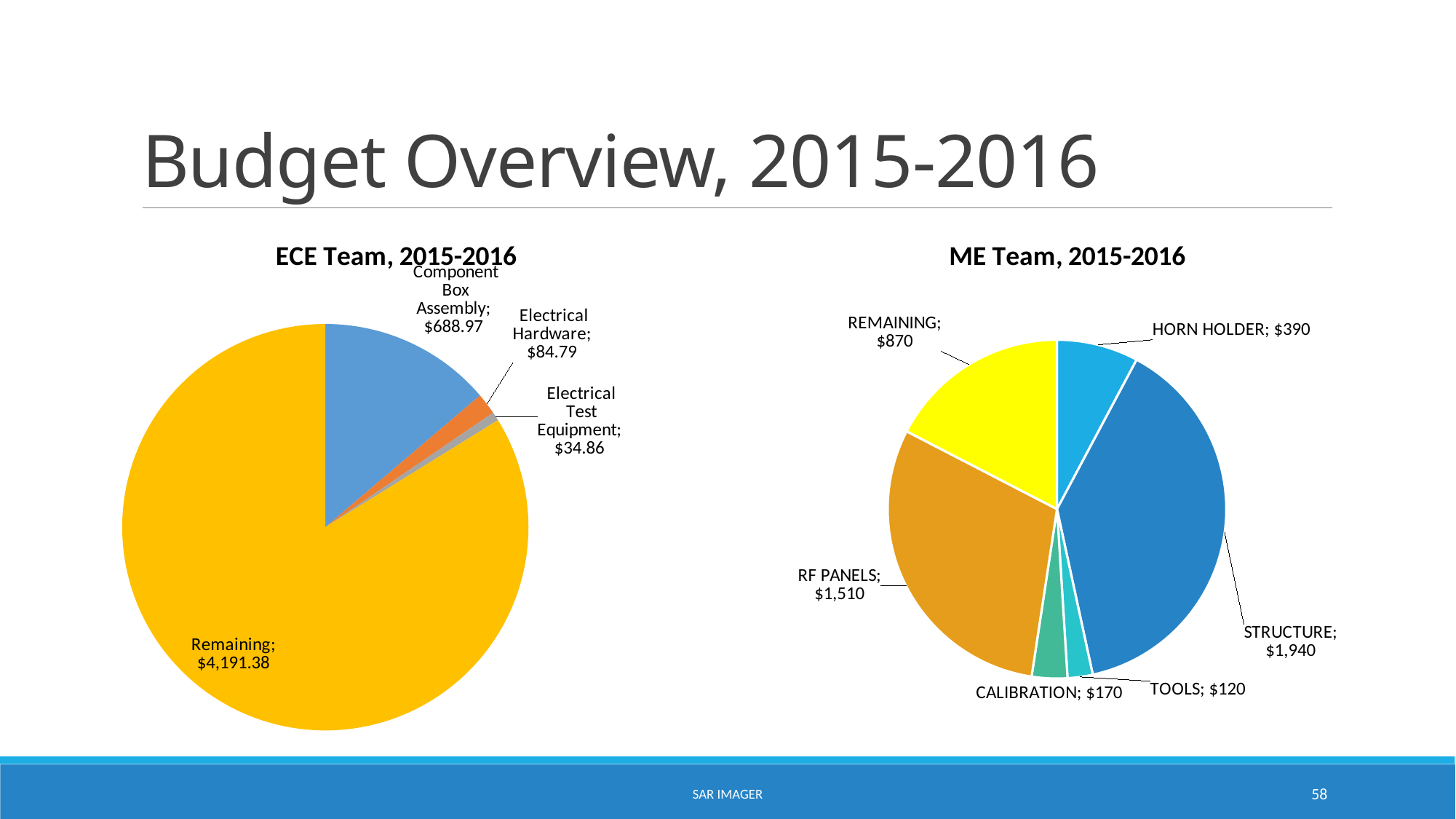
In the ECE Team, 2015-2016 chart, what is the difference between Component Box Assembly and Electrical Hardware? $604.18 In the ME Team, 2015-2016 chart, what is the value for RF PANELS? $1,510 In the ECE Team, 2015-2016 chart, what is the value for Component Box Assembly? $688.97 How many categories are shown in the ME Team, 2015-2016 chart? 6 In the ECE Team, 2015-2016 chart, what is the value for Electrical Test Equipment? $34.86 In the ME Team, 2015-2016 chart, what is the difference between STRUCTURE and RF PANELS? $430 In the ME Team, 2015-2016 chart, which category has the smallest value? TOOLS In the ME Team, 2015-2016 chart, what is the value for CALIBRATION? $170 In the ME Team, 2015-2016 chart, which category has the largest value? STRUCTURE In the ECE Team, 2015-2016 chart, which category has the smallest value? Electrical Test Equipment What kind of chart is the ECE Team, 2015-2016 chart? Pie chart In the ME Team, 2015-2016 chart, which is larger, HORN HOLDER or REMAINING? REMAINING